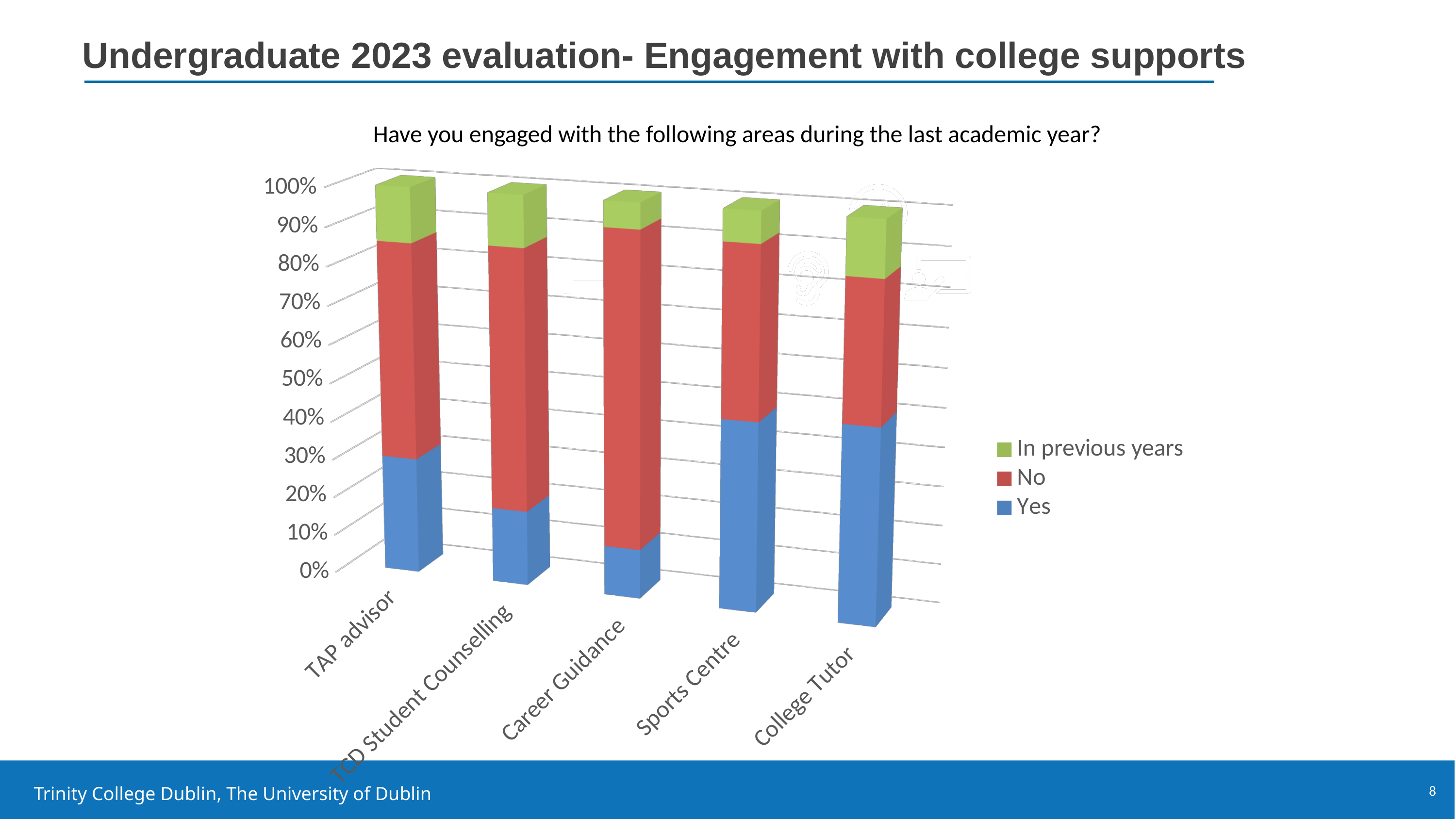
Is the 'Yes' value for TAP advisor greater or less than 20%? greater Is the 'Yes' value for Sports Centre greater or less than 30%? greater Which has the larger 'Yes' segment, TAP advisor or TCD Student Counselling? TAP advisor How many series does the chart's legend list? 3 How many categories (college supports) are shown on the x axis of the chart? 5 What is the title of the chart? Have you engaged with the following areas during the last academic year? What are the three series listed in the chart's legend? In previous years, No, Yes Which category has the largest 'No' segment? Career Guidance What kind of chart is shown on the slide? Stacked bar chart Which category has the smallest 'Yes' segment? Career Guidance